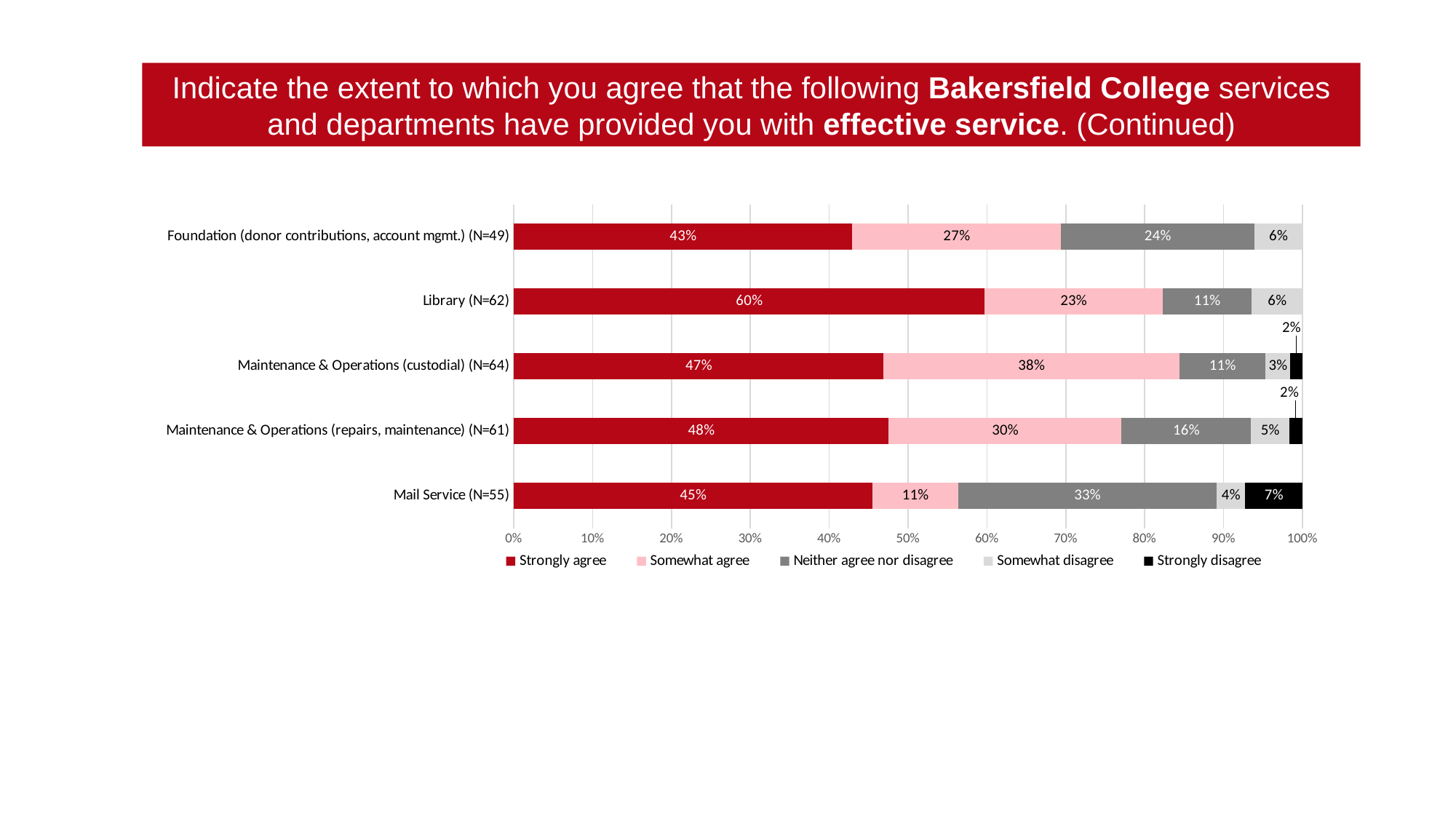
How many categories (services/departments) are shown in the chart? 5 What is the difference between the Strongly agree percentages for Library and Foundation? 17% What kind of chart is shown on the slide? Stacked bar chart What percentage of Mail Service respondents neither agree nor disagree? 33% Which category has the highest Strongly agree percentage? Library (N=62) What percentage of Maintenance & Operations (custodial) respondents somewhat agree? 38% Which category has the lowest Somewhat agree percentage? Mail Service (N=55) What percentage of Foundation (donor contributions, account mgmt.) respondents somewhat disagree? 6% What percentage of Library respondents strongly agree? 60% Which is larger: the Neither agree nor disagree percentage for Foundation or for Maintenance & Operations (repairs, maintenance)? Foundation (donor contributions, account mgmt.) (N=49) How many series does the legend list? 5 What percentage of Mail Service respondents strongly disagree? 7%